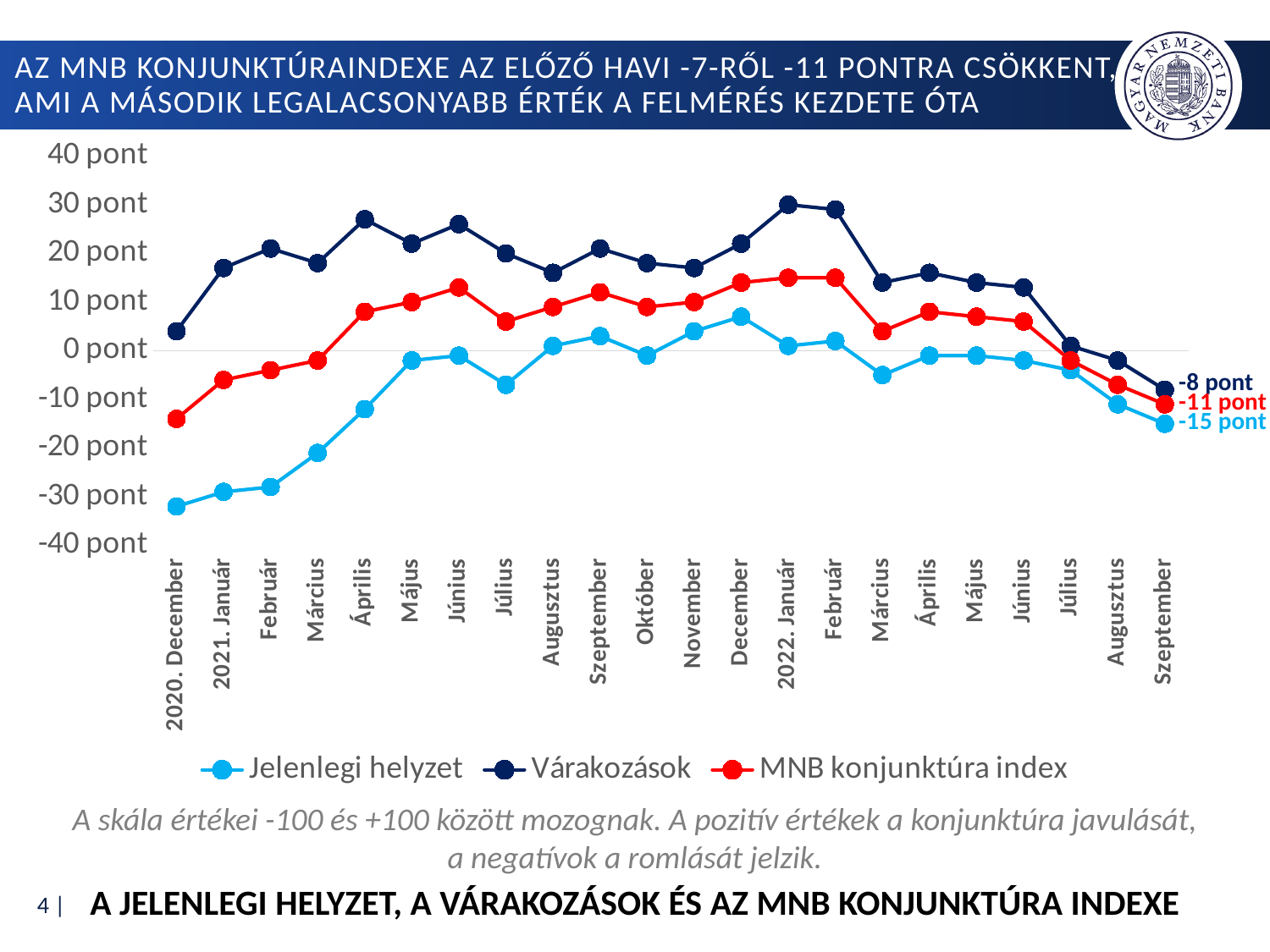
How many series does the legend list? 3 At the last point (Szeptember), what is the difference between the MNB konjunktúra index value and the Jelenlegi helyzet value? 4 pont What is the value of the MNB konjunktúra index series at the last point (Szeptember)? -11 pont What is the value of the Várakozások series at the last point (Szeptember)? -8 pont Is the value of the Várakozások series in 2022. Január greater or less than 20 pont? greater Is the value of the Jelenlegi helyzet series in 2020. December greater or less than -20 pont? less At the last point (Szeptember), what is the difference between the Várakozások value and the Jelenlegi helyzet value? 7 pont At the last point (Szeptember), which is larger: the Várakozások value or the Jelenlegi helyzet value? Várakozások What kind of chart is shown on the slide? line chart Does the Várakozások series rise or fall from 2022. Február to Szeptember? fall What is the value of the Jelenlegi helyzet series at the last point (Szeptember)? -15 pont How many months (data points) are shown on the x axis? 22